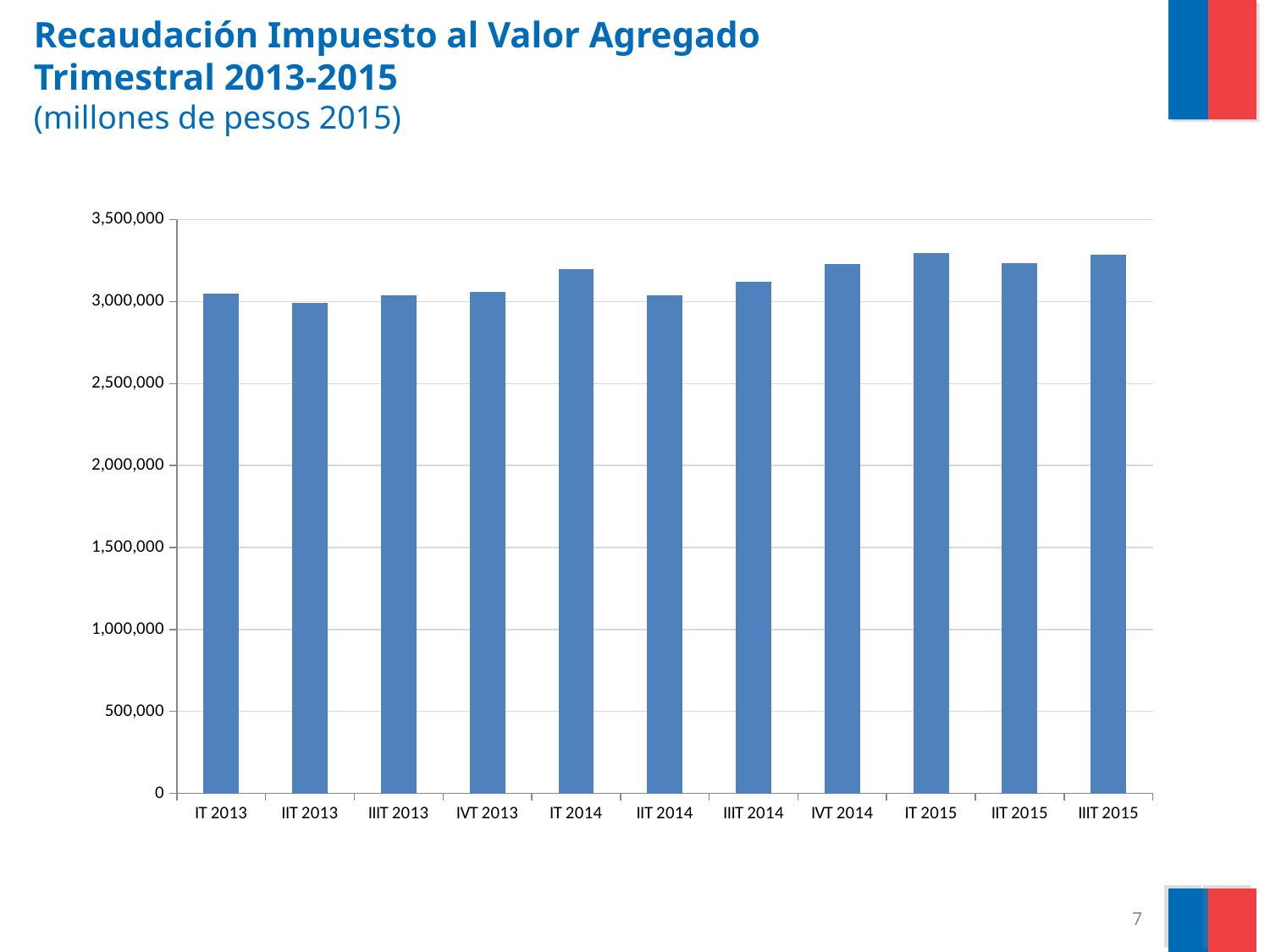
Which is larger, the value for IVT 2014 or the value for IIT 2013? IVT 2014 Which quarter has the lowest value on the chart? IIT 2013 In what units are the values on the chart expressed, according to the subtitle? millones de pesos 2015 Which is larger, the value for IT 2015 or the value for IT 2013? IT 2015 Is the value for IT 2014 greater or less than 3,500,000? less Is the value for IT 2015 greater or less than 3,000,000? greater How many quarters (bars) are plotted on the chart? 11 What is the title of the chart on the slide? Recaudación Impuesto al Valor Agregado Trimestral 2013-2015 Which is larger, the value for IT 2014 or the value for IIT 2014? IT 2014 What kind of chart is shown on the slide? bar chart Is the value for IVT 2013 greater or less than 2,500,000? greater